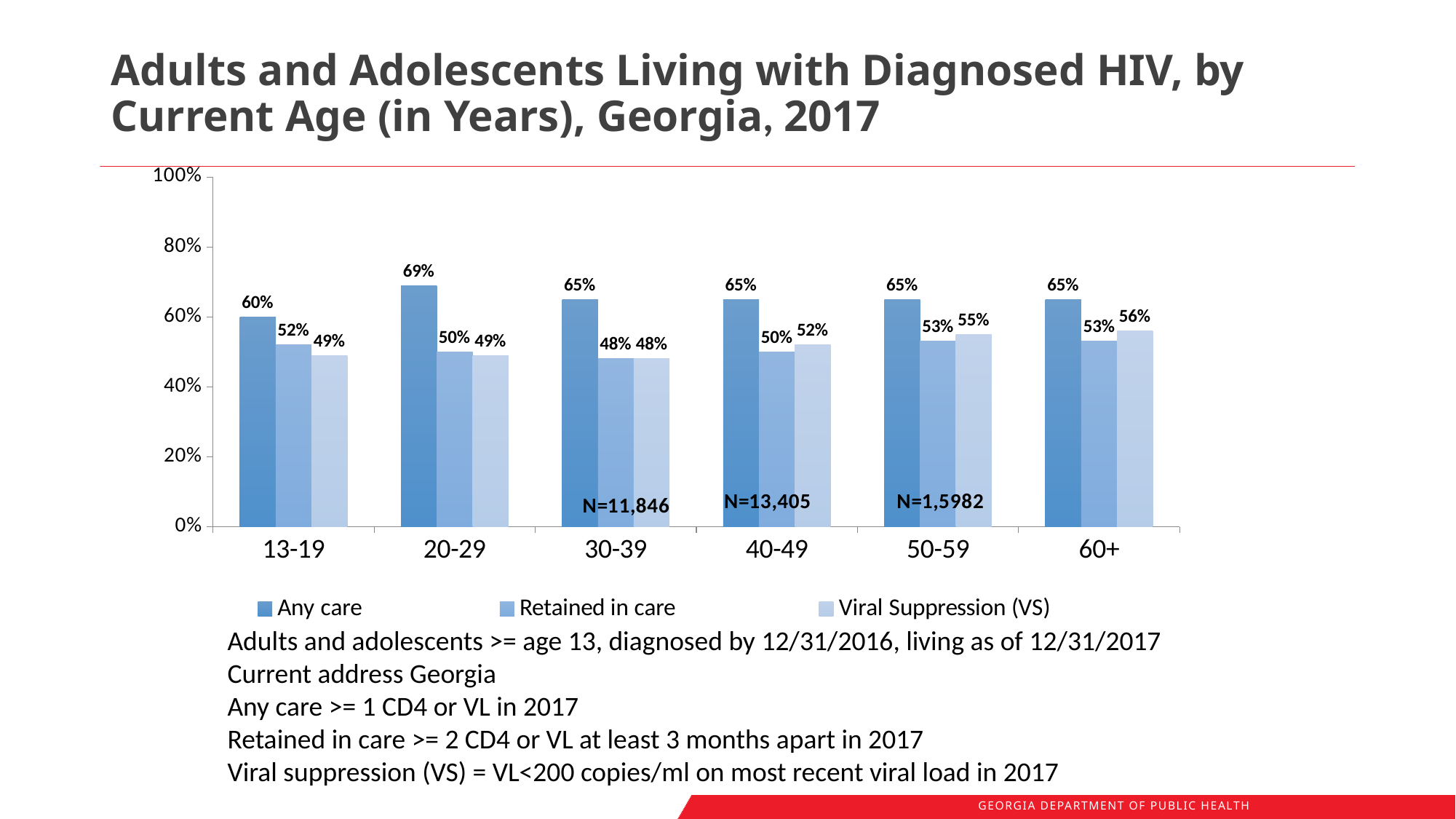
Which is larger for the 50-59 age group: Retained in care or Viral Suppression (VS)? Viral Suppression (VS) What is the Retained in care value for the 30-39 age group? 48% Which age group has the lowest Viral Suppression (VS) value? 30-39 How many series does the legend list? 3 What is the difference between the Any care and Viral Suppression (VS) values for the 13-19 age group? 11% What is the Viral Suppression (VS) value for the 60+ age group? 56% How many age groups are shown on the x axis? 6 What kind of chart is shown on the slide? Bar chart Does the Viral Suppression (VS) value rise or fall from the 30-39 age group to the 60+ age group? Rise What N value is printed for the 40-49 age group? N=13,405 Which age group has the highest Any care value? 20-29 What is the Any care value for the 20-29 age group? 69%